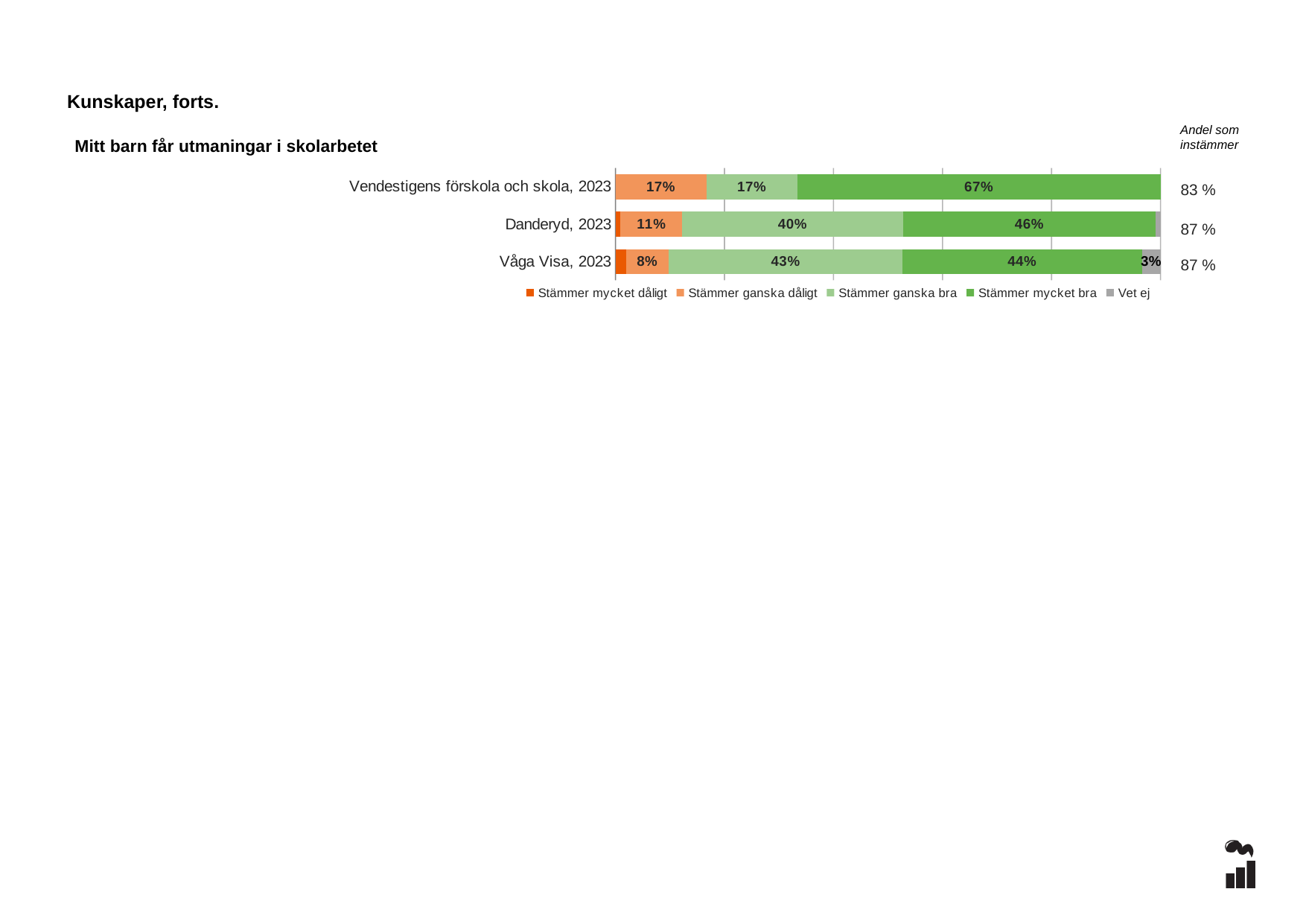
Which category has the highest 'Stämmer mycket bra' value? Vendestigens förskola och skola, 2023 What is the 'Andel som instämmer' value shown for Vendestigens förskola och skola, 2023? 83 % Which is larger: the 'Stämmer ganska dåligt' value for Vendestigens förskola och skola, 2023 or for Danderyd, 2023? Vendestigens förskola och skola, 2023 What kind of chart is shown on the slide? Stacked bar chart How many series does the legend list? 5 Which category has the lowest 'Stämmer ganska bra' value? Vendestigens förskola och skola, 2023 What is the 'Stämmer ganska bra' value for Danderyd, 2023? 40% What is the 'Stämmer ganska dåligt' value for Våga Visa, 2023? 8% What is the 'Vet ej' value for Våga Visa, 2023? 3% What is the 'Stämmer mycket bra' value for Vendestigens förskola och skola, 2023? 67% How many categories (bars) are shown in the chart? 3 What is the difference between the 'Stämmer mycket bra' values for Vendestigens förskola och skola, 2023 and Danderyd, 2023? 21 percentage points